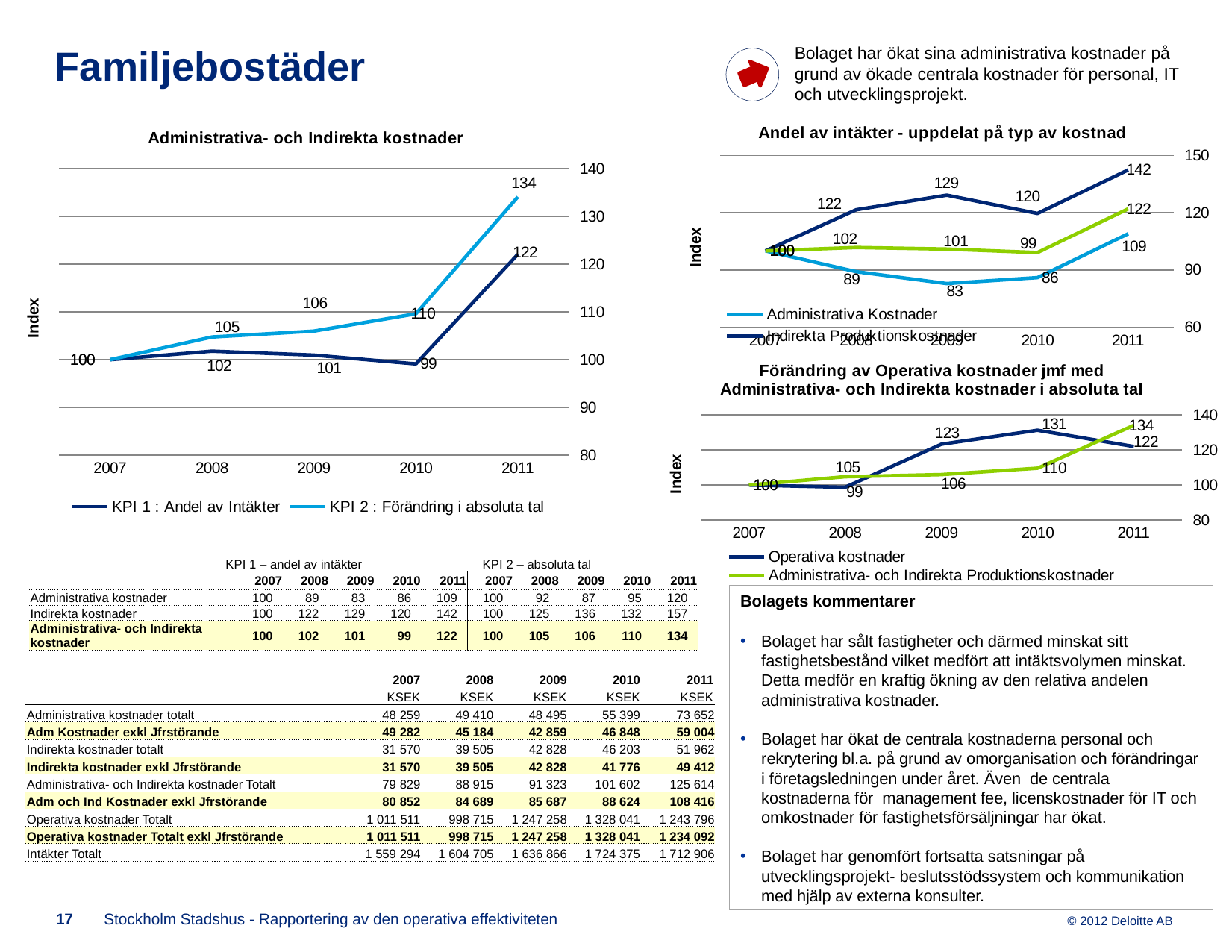
In the chart 'Administrativa- och Indirekta kostnader', how many series does the legend list? 2 In the chart 'Administrativa- och Indirekta kostnader', what is the difference between KPI 2 and KPI 1 in 2011? 12 In the chart 'Andel av intäkter - uppdelat på typ av kostnad', what is the value of Administrativa Kostnader in 2009? 83 In the chart 'Förändring av Operativa kostnader jmf med Administrativa- och Indirekta kostnader i absoluta tal', what is the value of Operativa kostnader in 2010? 131 In the chart 'Andel av intäkter - uppdelat på typ av kostnad', what is the value of Indirekta Produktionskostnader in 2011? 142 What type of chart is 'Administrativa- och Indirekta kostnader'? Line chart In the chart 'Andel av intäkter - uppdelat på typ av kostnad', in which year is Indirekta Produktionskostnader highest? 2011 In the chart 'Förändring av Operativa kostnader jmf med Administrativa- och Indirekta kostnader i absoluta tal', which series has the higher value in 2011, Operativa kostnader or Administrativa- och Indirekta Produktionskostnader? Administrativa- och Indirekta Produktionskostnader In the chart 'Administrativa- och Indirekta kostnader', what is the value of KPI 2 : Förändring i absoluta tal in 2011? 134 In the chart 'Förändring av Operativa kostnader jmf med Administrativa- och Indirekta kostnader i absoluta tal', how many years are shown on the x axis? 5 In the chart 'Administrativa- och Indirekta kostnader', in which year is KPI 1 : Andel av Intäkter lowest? 2010 In the chart 'Administrativa- och Indirekta kostnader', what is the value of KPI 1 : Andel av Intäkter in 2010? 99